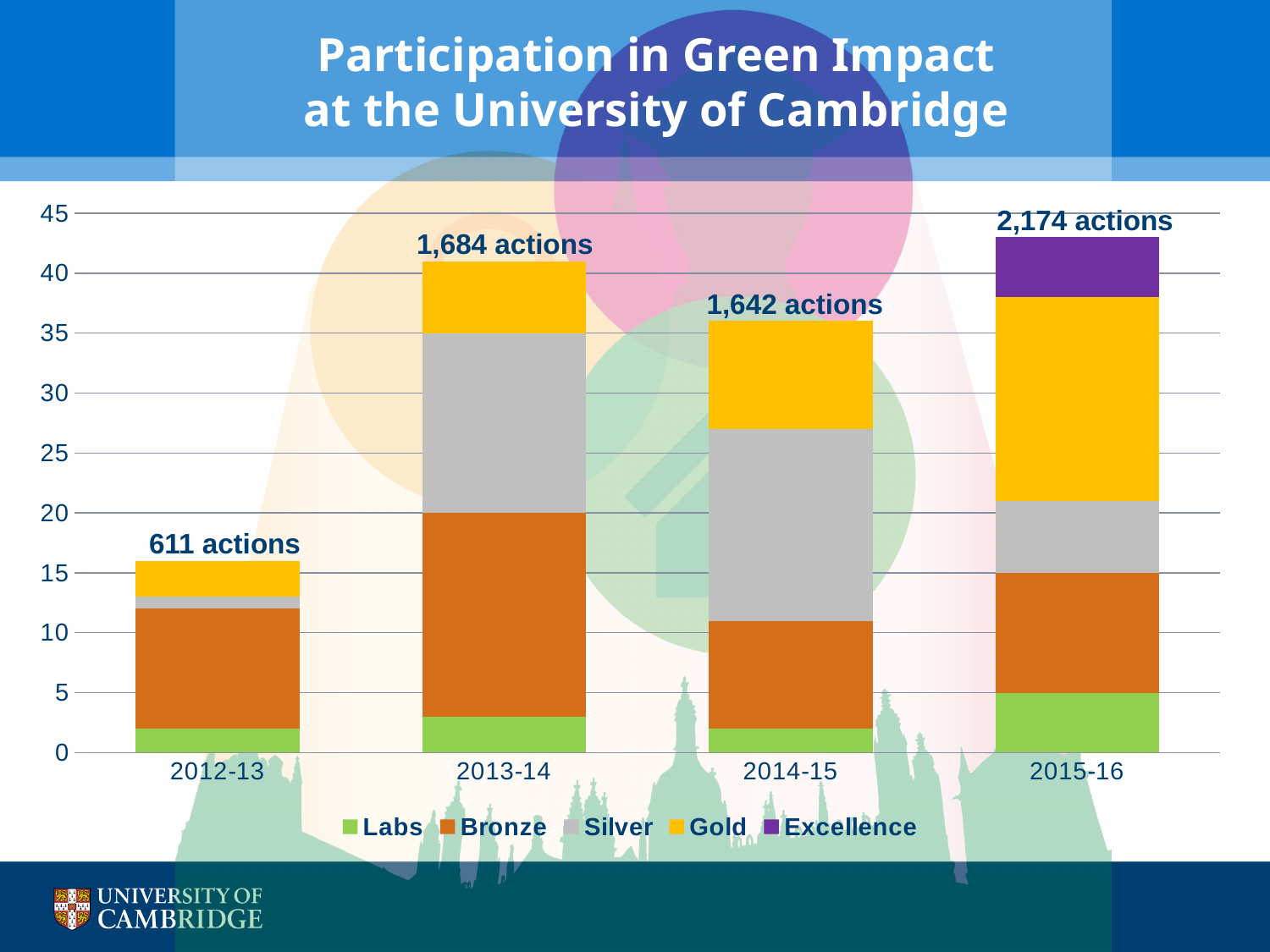
Which year has the highest labelled number of actions? 2015-16 What type of chart is shown on the slide? Stacked bar chart Is the Bronze segment larger in 2013-14 or in 2014-15? 2013-14 How many series does the legend list? 5 What number of actions is labelled above the 2013-14 bar? 1,684 actions Which year has the lowest total bar? 2012-13 What number of actions is labelled above the 2015-16 bar? 2,174 actions What number of actions is labelled above the 2012-13 bar? 611 actions How many academic years are shown on the x axis? 4 Is the total bar height for 2012-13 greater or less than 20? less Which series appears only in the 2015-16 bar? Excellence What is the difference between the labelled actions for 2015-16 and 2012-13? 1,563 actions